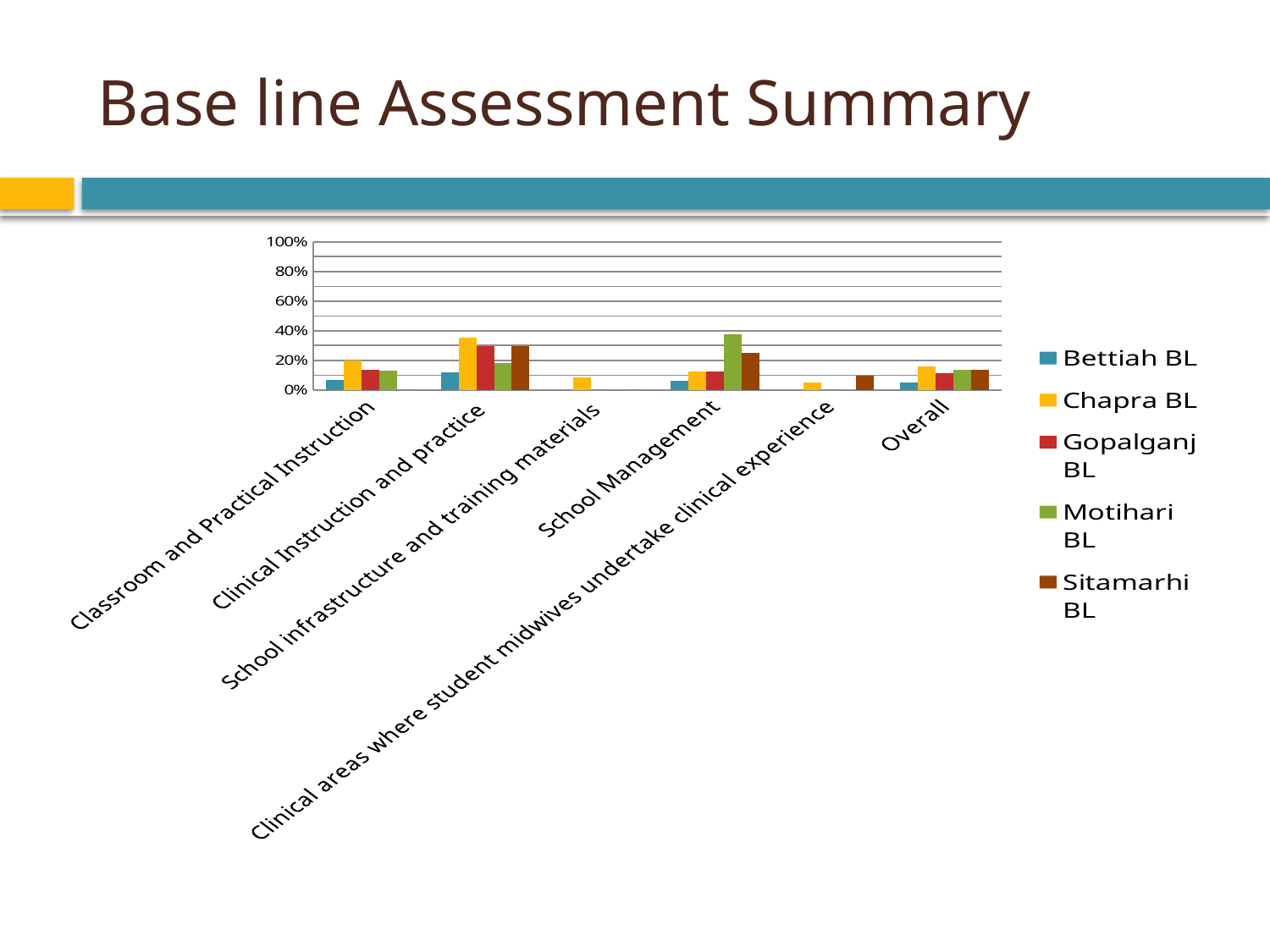
Is the value for Chapra BL in Clinical Instruction and practice greater or less than 20%? greater How many categories are shown along the x axis of the chart? 6 Which series has the lowest value for Overall? Bettiah BL Is the value for Motihari BL in School Management greater or less than 20%? greater What colour represents Chapra BL in the legend? yellow What kind of chart is shown on the slide? bar chart Which series is the only one with a visible bar for School infrastructure and training materials? Chapra BL For Classroom and Practical Instruction, which is larger: Chapra BL or Bettiah BL? Chapra BL Which series has the highest value for Clinical Instruction and practice? Chapra BL Is the value for Bettiah BL in Classroom and Practical Instruction greater or less than 20%? less Which series has the highest value for School Management? Motihari BL How many series does the chart's legend list? 5